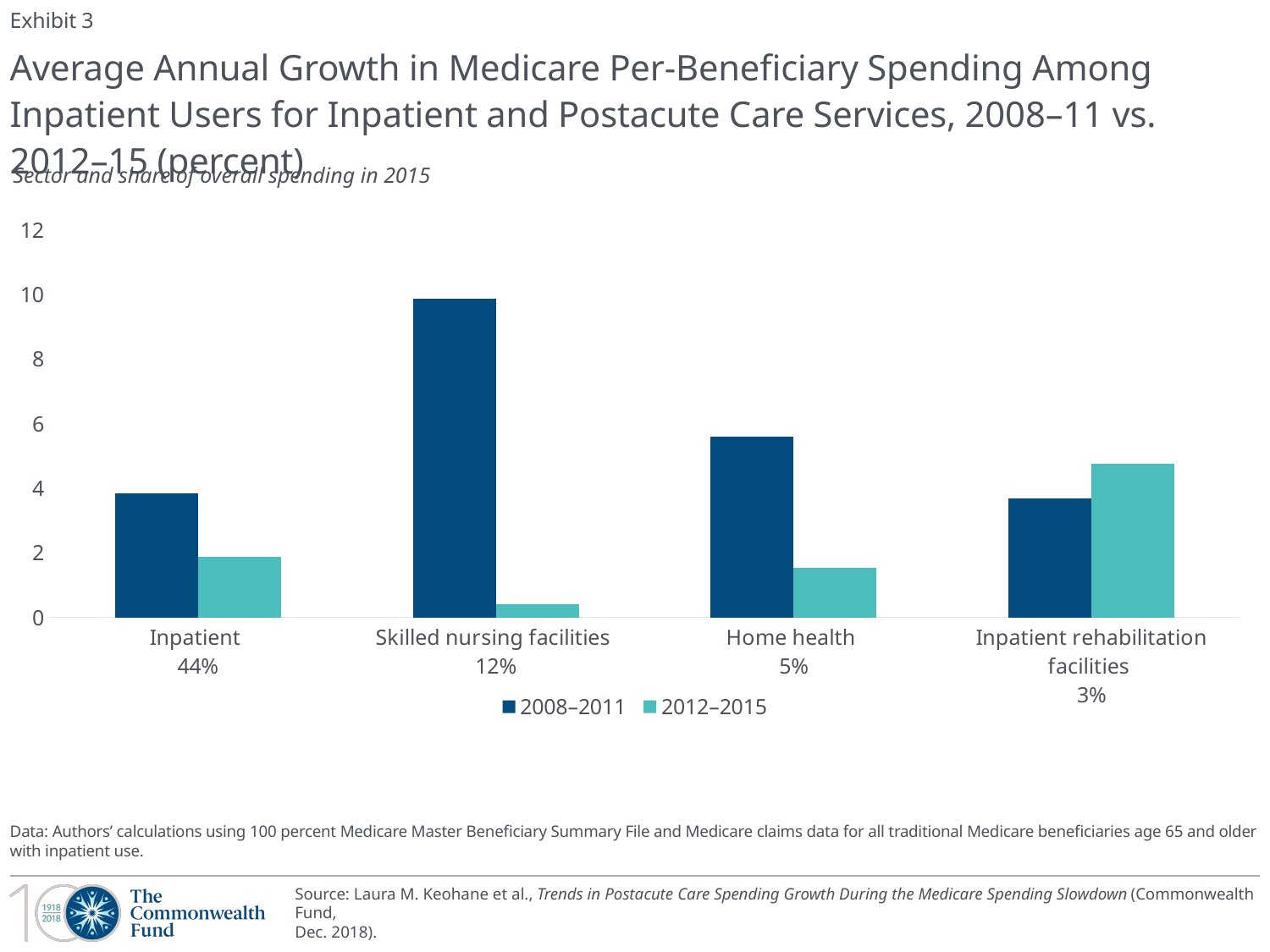
What share of overall spending in 2015 is shown for Skilled nursing facilities? 12% How many sectors (categories) are shown on the x axis? 4 What are the two periods listed in the legend? 2008–2011 and 2012–2015 What type of chart is shown on the slide? Bar chart Is the 2012–2015 value for Inpatient greater or less than 4? less Which sector has the highest value for 2012–2015? Inpatient rehabilitation facilities Which sector has the highest value for 2008–2011? Skilled nursing facilities Is the 2008–2011 value for Skilled nursing facilities greater or less than 8? greater For Inpatient rehabilitation facilities, which period has the larger value, 2008–2011 or 2012–2015? 2012–2015 For Home health, which period has the larger value, 2008–2011 or 2012–2015? 2008–2011 Which sector has the lowest value for 2012–2015? Skilled nursing facilities How many series does the legend list? 2